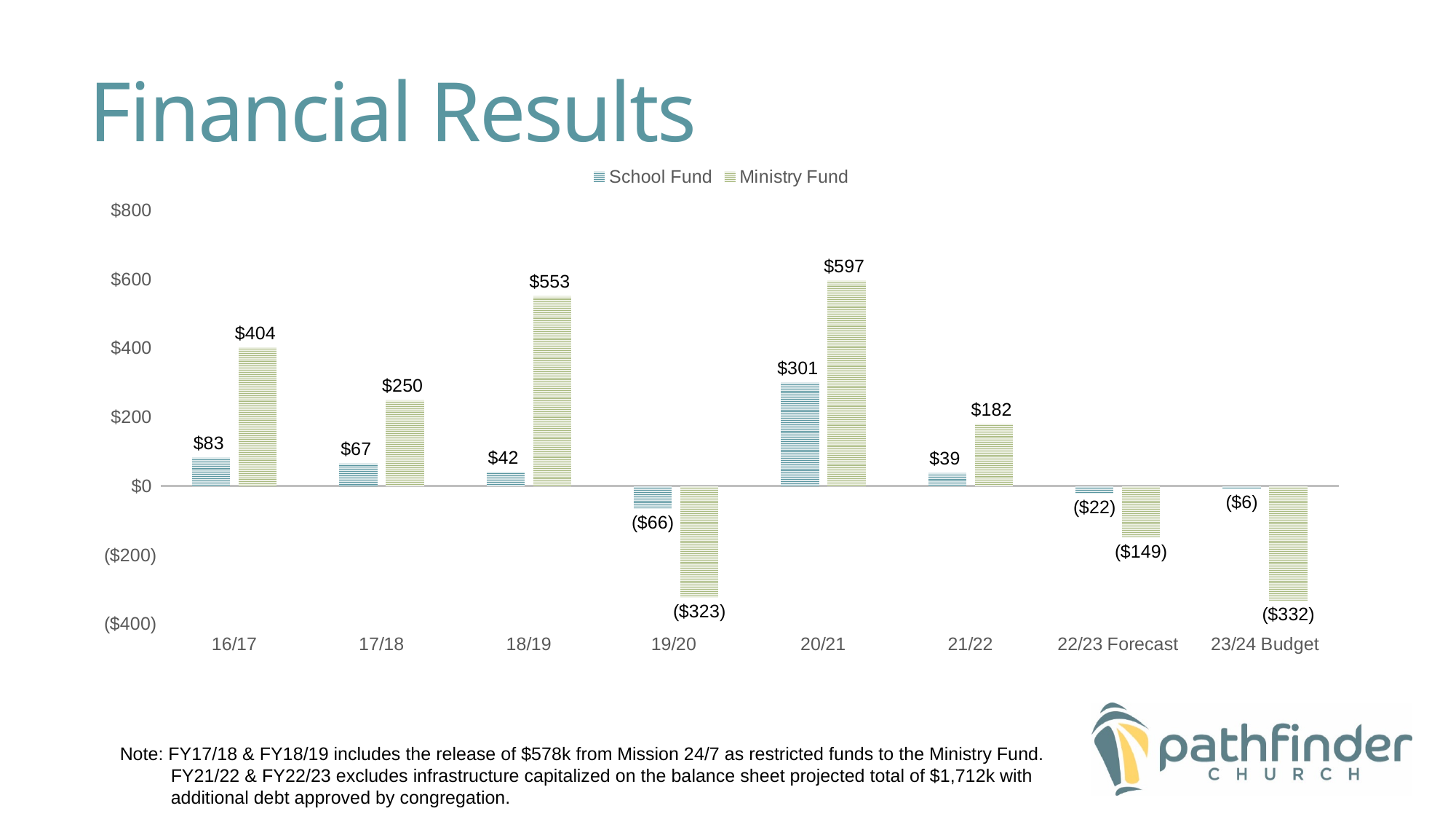
How much larger is the Ministry Fund value in 20/21 than in 18/19? $44 What is the Ministry Fund value for 18/19? $553 In which year is the Ministry Fund value highest? 20/21 What is the School Fund value for 22/23 Forecast? ($22) What is the School Fund value for 20/21? $301 How many fiscal year categories are shown on the x axis? 8 In which year is the School Fund value highest? 20/21 In which year is the Ministry Fund value lowest? 23/24 Budget Which year has the larger School Fund value, 16/17 or 17/18? 16/17 What is the Ministry Fund value for 23/24 Budget? ($332) How many series does the legend list? 2 What kind of chart is shown on the slide? Bar chart